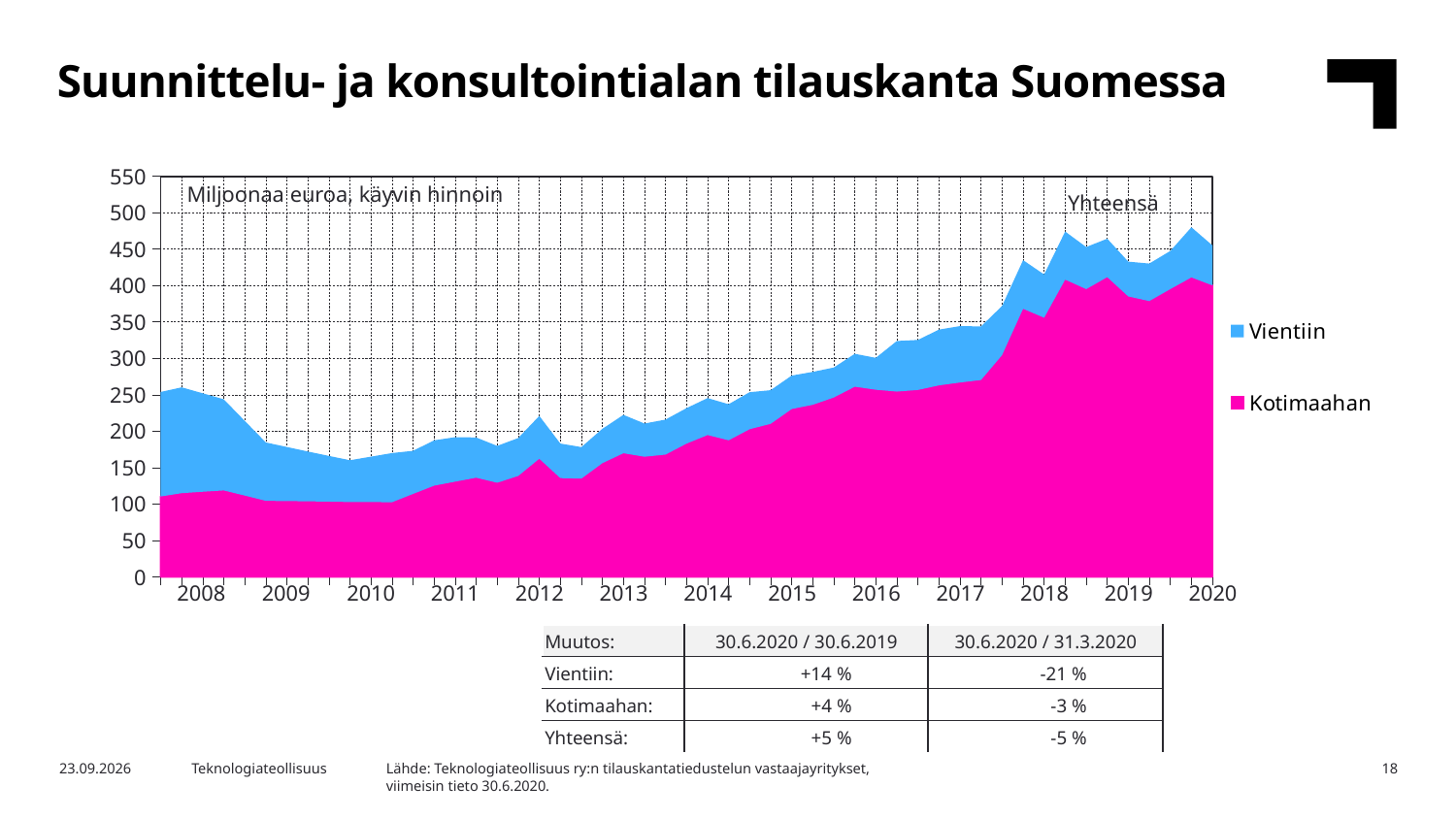
Is the total (Yhteensä) value at the start of 2010 greater or less than 200? less How many year labels are shown on the x axis of the chart? 13 How many series does the chart legend list? 2 What are the two series named in the chart legend? Vientiin and Kotimaahan Does the Kotimaahan series generally rise or fall from 2010 to 2020? rise Is the Kotimaahan value at the start of 2013 greater or less than 200? less Is the total (Yhteensä) value at the start of 2020 greater or less than 400? greater At the start of 2020, which series is larger, Vientiin or Kotimaahan? Kotimaahan What kind of chart is shown on the slide? Stacked area chart What unit is stated in the text box inside the chart? Miljoonaa euroa, käyvin hinnoin